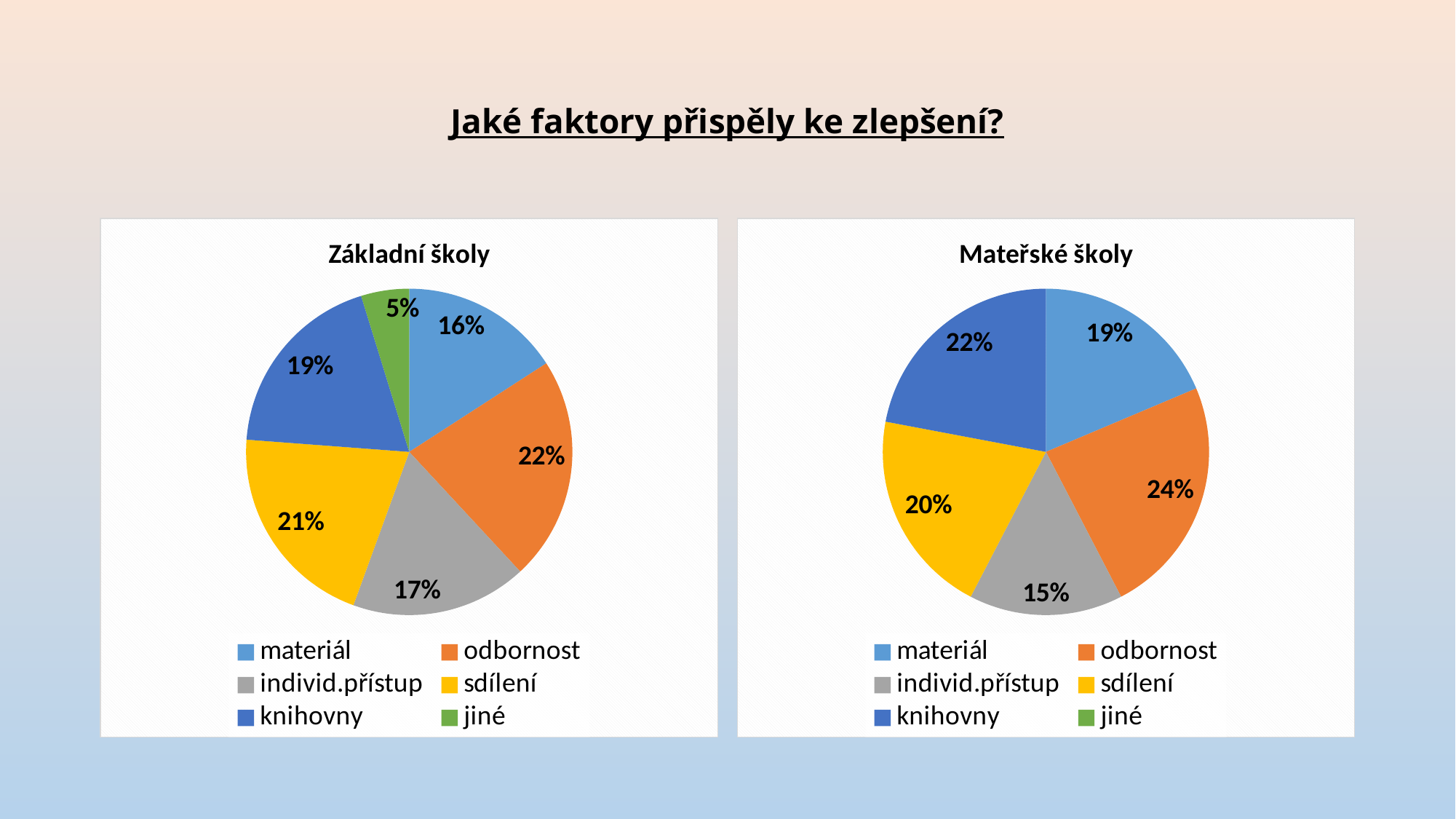
In the 'Základní školy' chart, which category has the smallest slice? jiné In the 'Mateřské školy' chart, which category has the smallest visible slice? individ.přístup What type of chart is used for 'Základní školy'? Pie chart In the 'Základní školy' chart, what share does 'odbornost' have? 22% In the 'Mateřské školy' chart, which is larger: the share of 'materiál' or the share of 'sdílení'? sdílení How many categories does the legend of the 'Základní školy' chart list? 6 In the 'Mateřské školy' chart, what share does 'individ.přístup' have? 15% In the 'Základní školy' chart, which category has the largest slice? odbornost In the 'Mateřské školy' chart, which category has the largest slice? odbornost In the 'Mateřské školy' chart, what share does 'knihovny' have? 22% In the 'Základní školy' chart, what share does 'jiné' have? 5% In the 'Základní školy' chart, what is the difference between the shares of 'sdílení' and 'materiál'? 5 percentage points